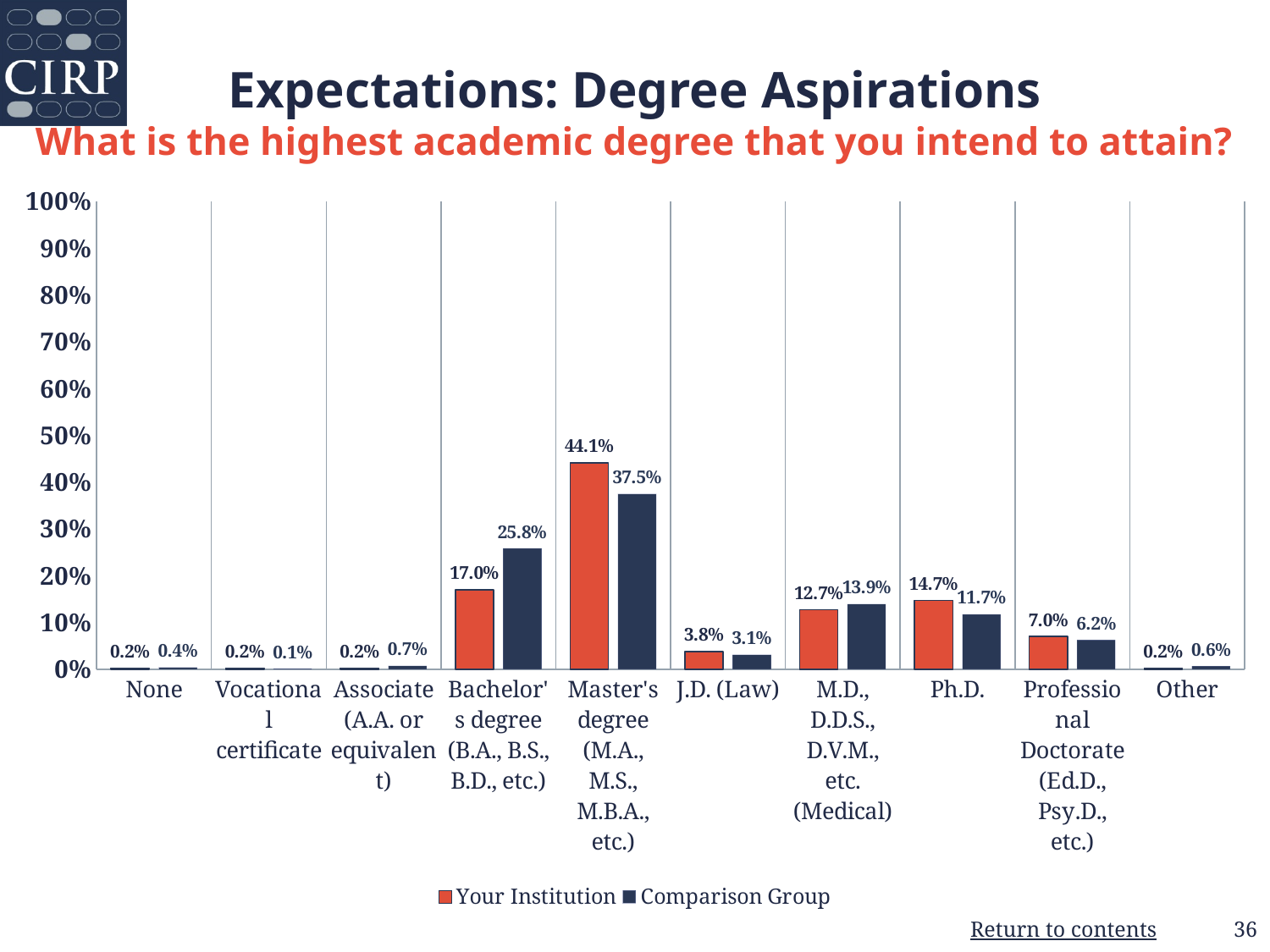
What is the value for Comparison Group for J.D. (Law)? 3.1% What is the difference between Your Institution and Comparison Group for Professional Doctorate? 0.8% What is the value for Comparison Group for Bachelor's degree? 25.8% What is the value for Your Institution for Ph.D.? 14.7% What is the value for Your Institution for Master's degree? 44.1% Which category has the highest value for Your Institution? Master's degree Which category has the lowest value for Comparison Group? Vocational certificate How many series does the legend list? 2 How many categories are shown on the x axis? 10 Which is larger for Bachelor's degree: Your Institution or Comparison Group? Comparison Group What kind of chart is shown on the slide? Bar chart What is the difference between Your Institution and Comparison Group for Master's degree? 6.6%